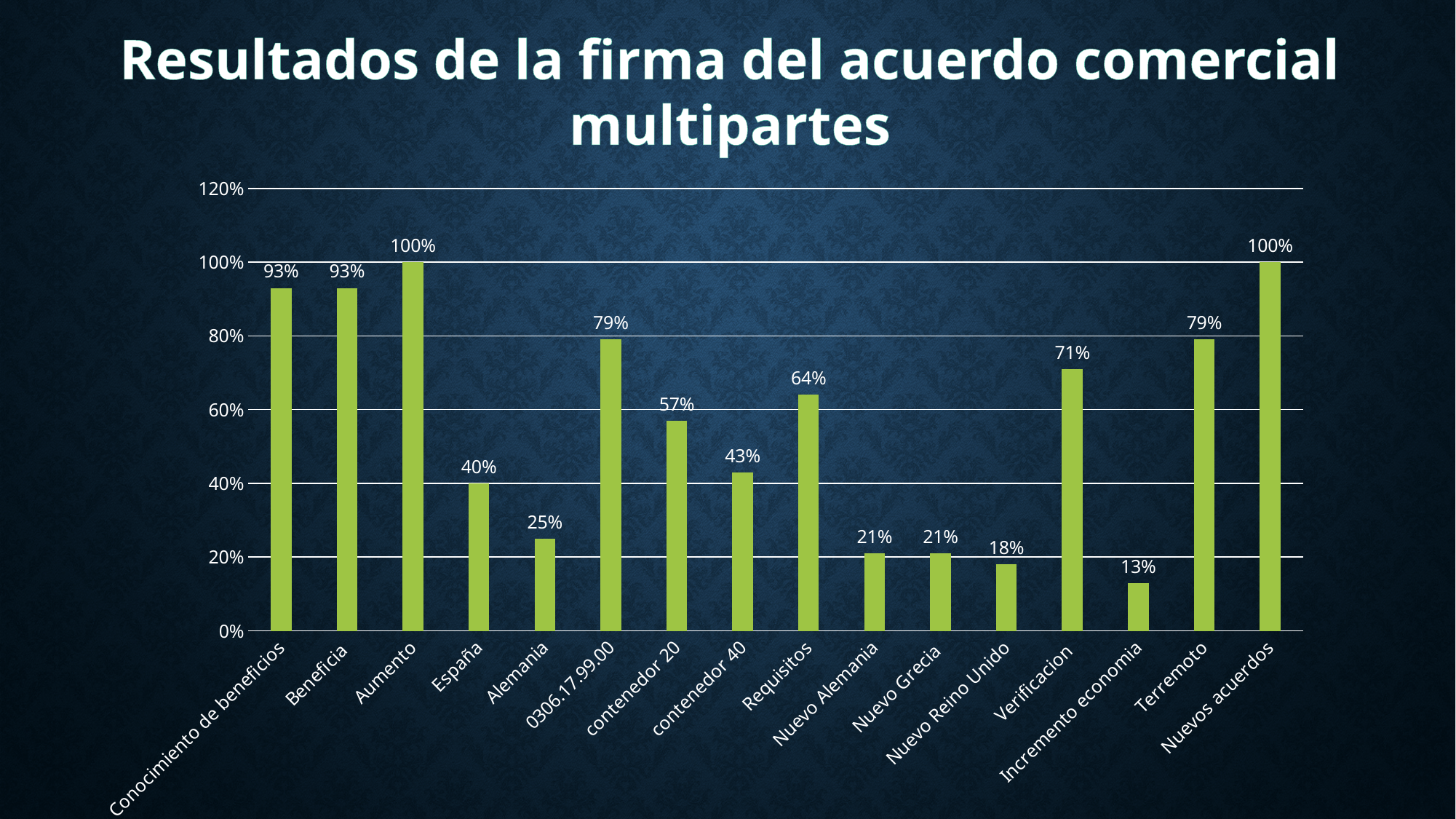
What is the value for Nuevo Reino Unido? 18% What is the difference between the values for Aumento and Terremoto? 21% What is the difference between the values for España and Alemania? 15% What is the value for Verificacion? 71% Is the value for Terremoto greater or less than 60%? greater How many categories are shown on the x axis? 16 Which is larger, the value for contenedor 40 or the value for Requisitos? Requisitos What kind of chart is shown on the slide? Bar chart Which category has the lowest value? Incremento economia What is the value for Requisitos? 64% What is the value for contenedor 20? 57% What is the value for Incremento economia? 13%